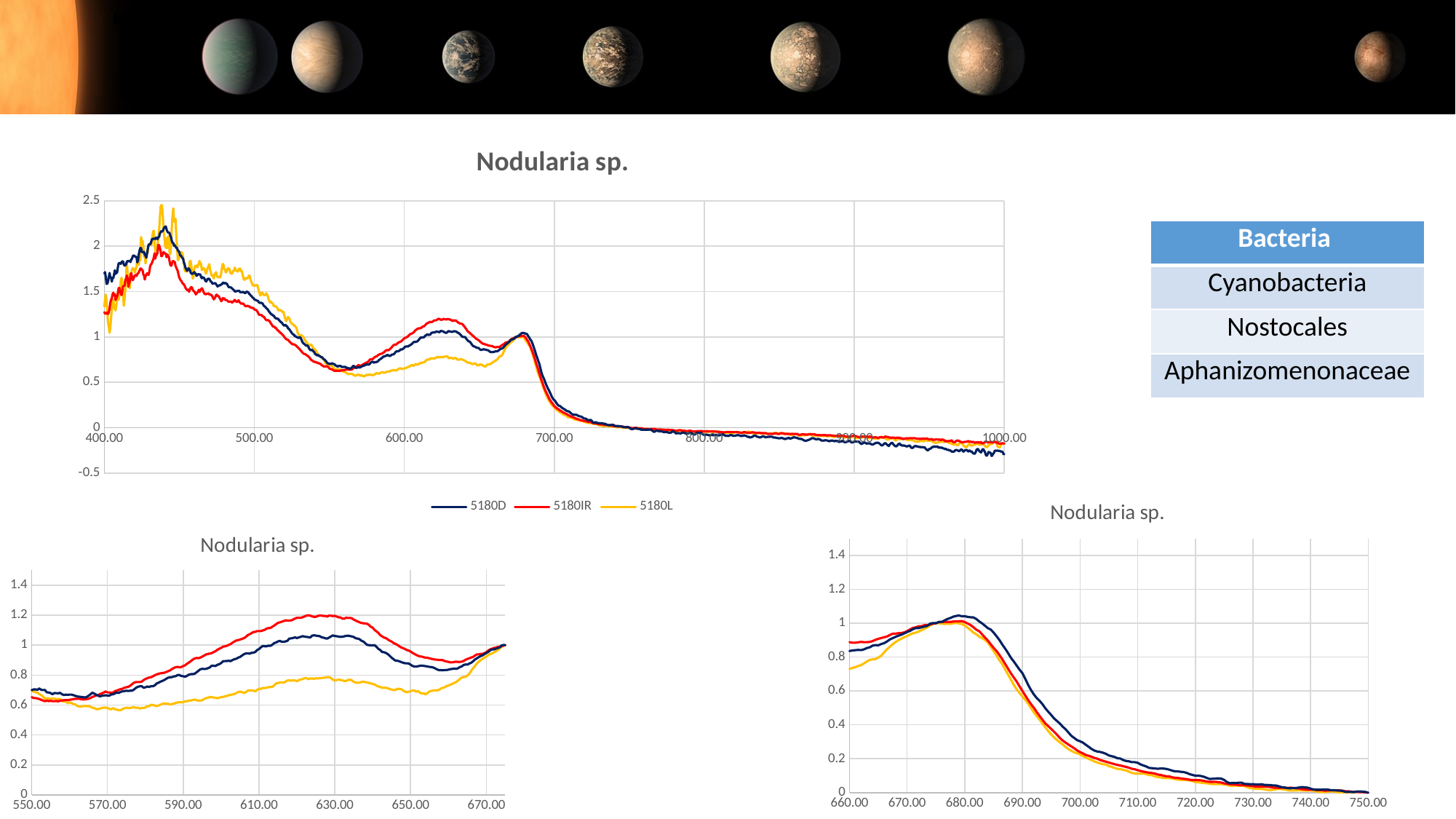
What are the legend entries of the top chart? 5180D, 5180IR, 5180L In the top chart, is the peak value of the 5180L series near 440 greater or less than 2? greater In the top chart, at 630, which series has the larger value, 5180IR or 5180L? 5180IR In the bottom-right chart, do the values rise or fall between 690.00 and 750.00? fall In the bottom-left chart, is the value of the yellow line at 630.00 greater or less than 1? less How many series does the legend of the top chart list? 3 In the bottom-left chart, is the value of the red line at 630.00 greater or less than 1? greater What kind of chart is the top chart titled Nodularia sp.? line chart What is the title shared by all three charts on the slide? Nodularia sp. In the bottom-left chart, does the red line rise or fall between 570.00 and 630.00? rise